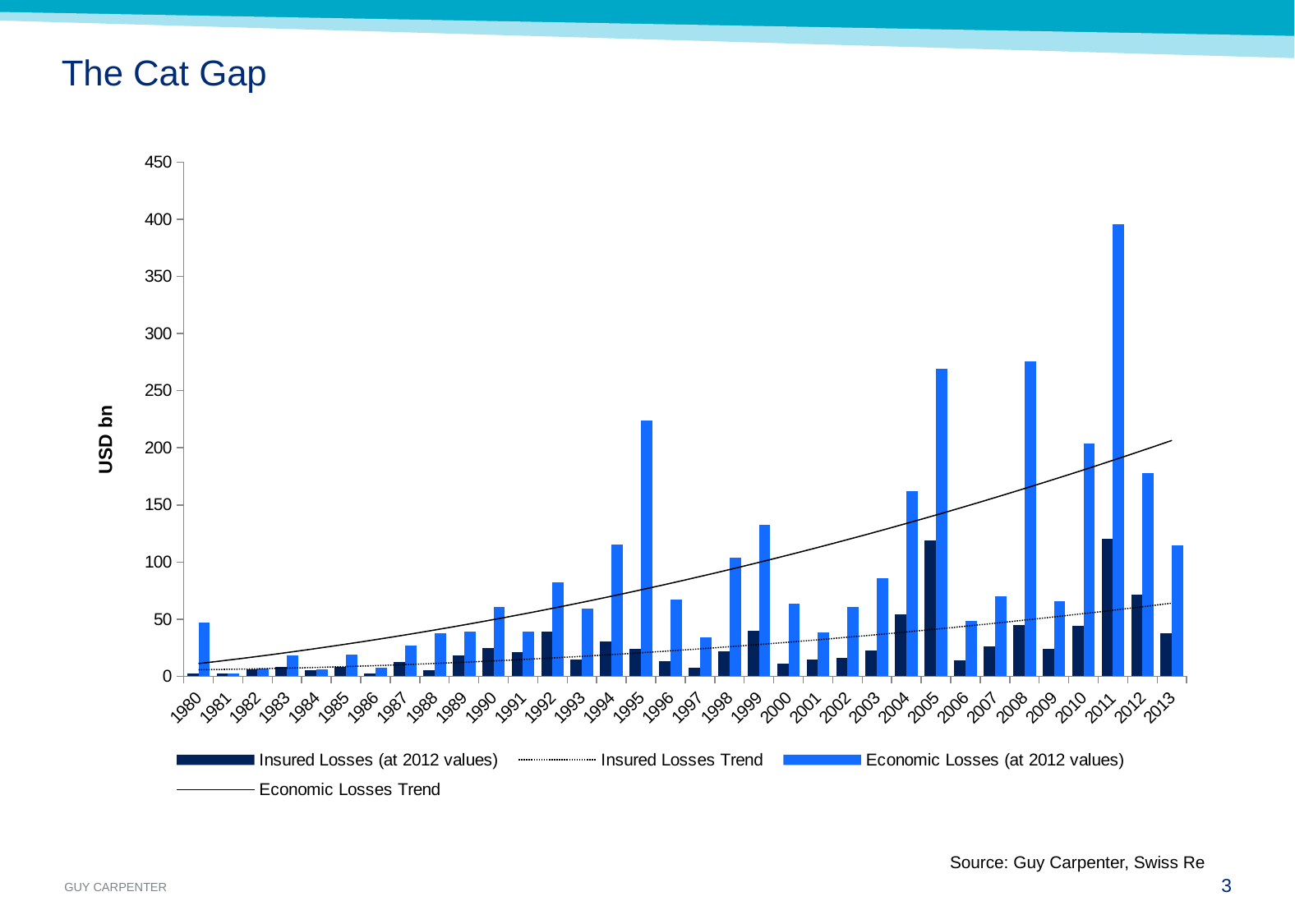
How many series does the legend list? 4 Is the value of Economic Losses (at 2012 values) for 2011 greater or less than 350? greater Is the value of Insured Losses (at 2012 values) for 2005 greater or less than 100? greater Which year has the highest Economic Losses (at 2012 values)? 2011 Is the value of Economic Losses (at 2012 values) for 1995 greater or less than 200? greater What is the label on the vertical axis? USD bn How many years are shown on the x axis? 34 What kind of chart is shown on the slide? bar chart Which is larger, Economic Losses (at 2012 values) for 2011 or for 2005? 2011 Does the Economic Losses Trend line rise or fall from 1980 to 2013? rise